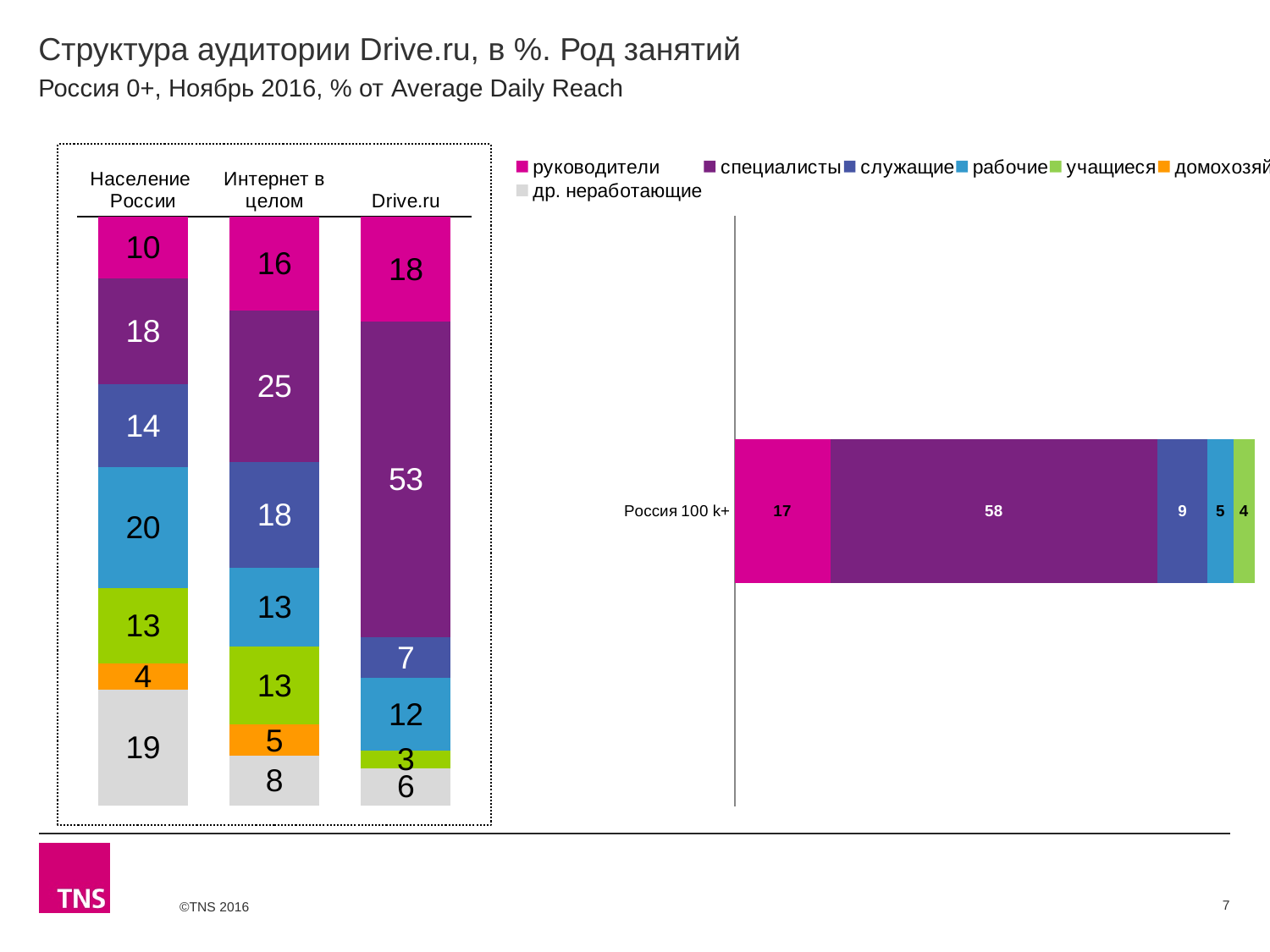
How many series does the legend list? 7 In the left chart, which has the larger рабочие value: Население России or Drive.ru? Население России How many columns (audience groups) are shown in the left chart? 3 In the left chart, what is the value of the руководители segment for Интернет в целом? 16 In the right chart, what is the total of all labelled segments in the Россия 100 k+ bar? 93 In the right chart, which segment of the Россия 100 k+ bar is the smallest? учащиеся In the left chart, what is the value of the специалисты segment for Drive.ru? 53 What kind of chart is the chart on the right (Россия 100 k+)? Stacked bar chart In the left chart, what is the difference between the специалисты value for Drive.ru and for Население России? 35 In the left chart, what is the value of the др. неработающие segment for Население России? 19 In the left chart, which column has the largest специалисты segment? Drive.ru In the right chart, what is the value of the специалисты segment for Россия 100 k+? 58